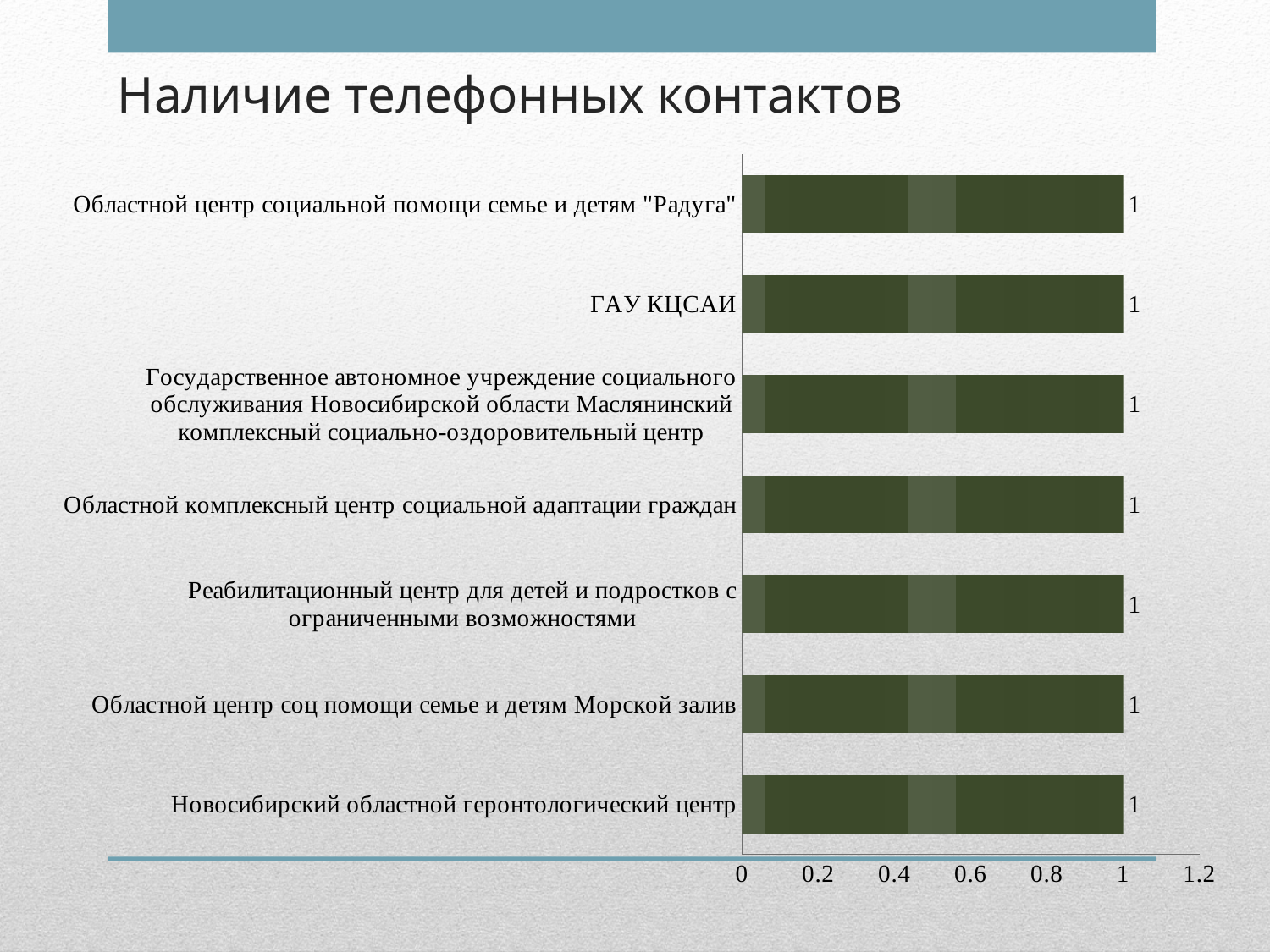
Do all the bars in the chart have the same value? Yes Is the value for Областной комплексный центр социальной адаптации граждан greater or less than 0.8? greater What is the difference between the values for ГАУ КЦСАИ and Новосибирский областной геронтологический центр? 0 What is the value for ГАУ КЦСАИ? 1 What is the highest tick value shown on the horizontal axis? 1.2 What is the value for Областной центр социальной помощи семье и детям "Радуга"? 1 What is the value for Реабилитационный центр для детей и подростков с ограниченными возможностями? 1 What is the value for Новосибирский областной геронтологический центр? 1 What kind of chart is shown on the slide? bar chart How many categories are shown in the chart? 7 What is the value for Областной центр соц помощи семье и детям Морской залив? 1 What is the title of the slide? Наличие телефонных контактов